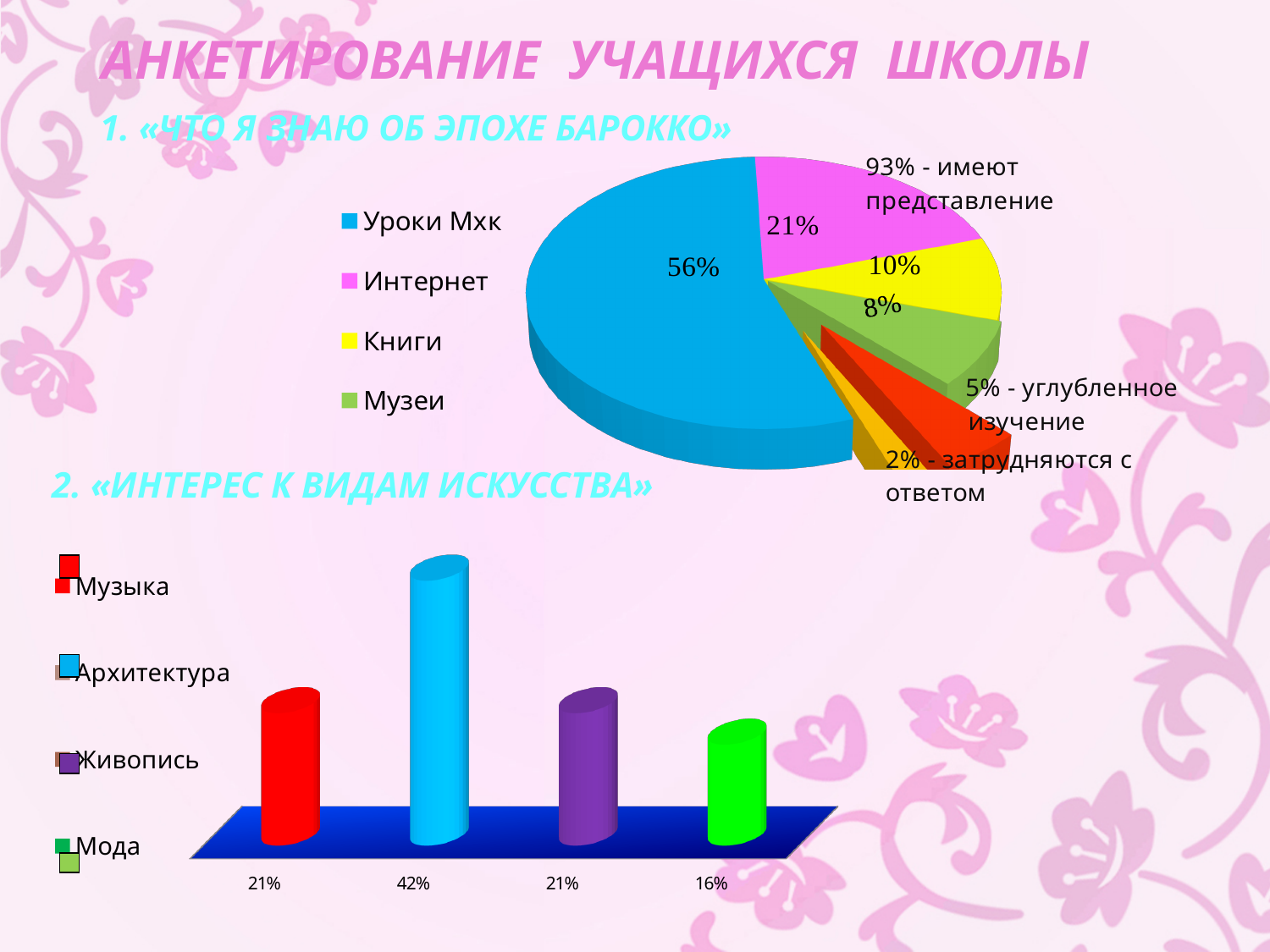
In the pie chart «Что я знаю об эпохе барокко», what share is shown for Книги? 10% In the bar chart «Интерес к видам искусства», what is the difference between the values for Архитектура and Мода? 26% In the bar chart «Интерес к видам искусства», what value is shown for Архитектура? 42% In the pie chart «Что я знаю об эпохе барокко», how many entries does the legend list? 4 What type of chart is the top chart «Что я знаю об эпохе барокко»? Pie chart In the bar chart «Интерес к видам искусства», which category has the highest bar? Архитектура In the pie chart «Что я знаю об эпохе барокко», what share is shown for Уроки Мхк? 56% In the pie chart «Что я знаю об эпохе барокко», what share is shown for Интернет? 21% In the pie chart «Что я знаю об эпохе барокко», which legend category has the largest slice? Уроки Мхк In the bar chart «Интерес к видам искусства», how many bars are plotted? 4 In the bar chart «Интерес к видам искусства», what value is shown for Мода? 16% In the pie chart «Что я знаю об эпохе барокко», which is larger: the slice for Книги or the slice for Музеи? Книги